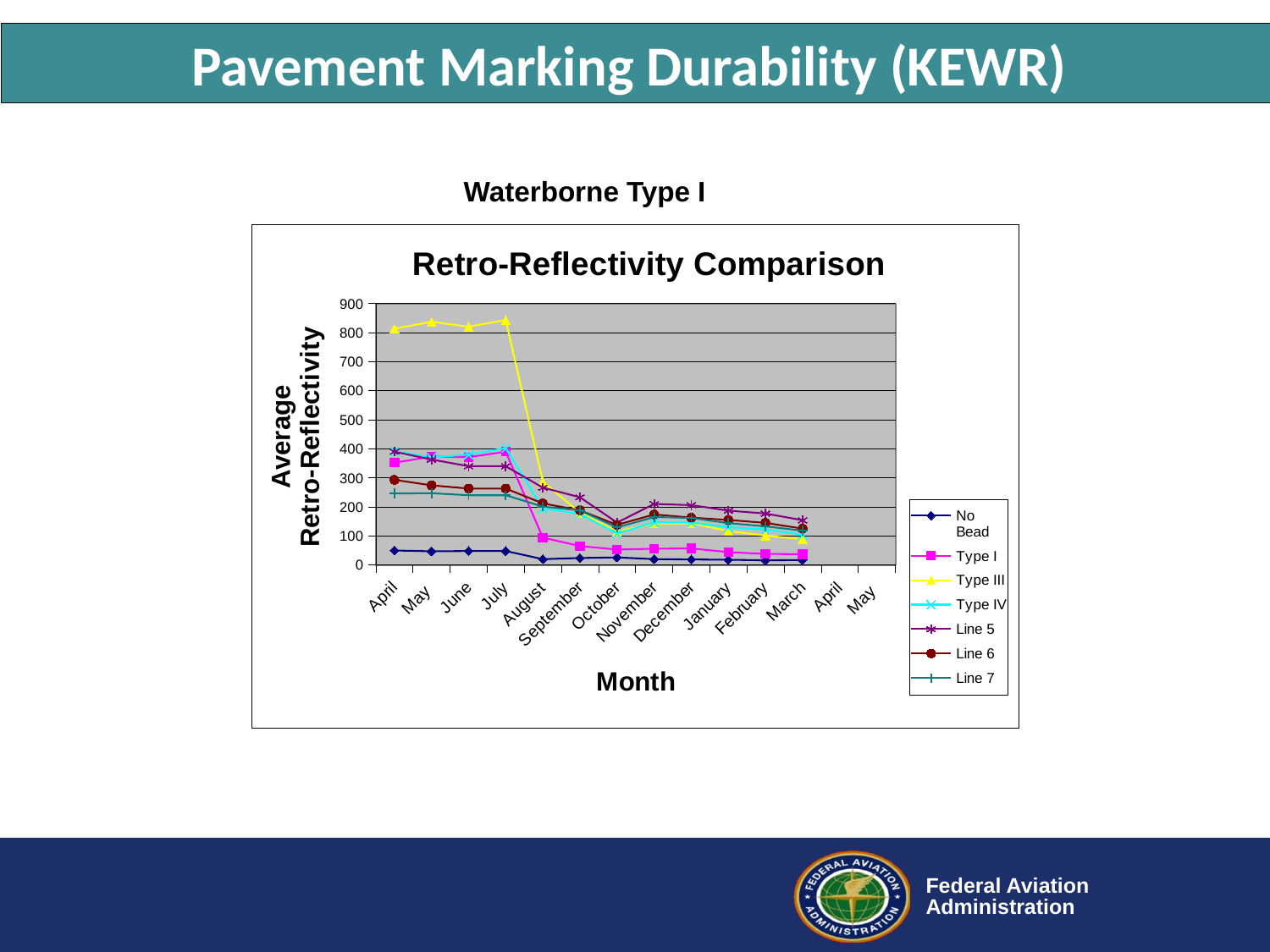
Does the Type III series rise or fall overall from April to March? fall Which series has the lowest value in April? No Bead How many series does the legend of the Retro-Reflectivity Comparison chart list? 7 Which series has the highest value in April? Type III In July, which is larger: the value for Type III or the value for No Bead? Type III Is the value for No Bead in April greater or less than 100? less Is the value for Line 7 in April greater or less than 300? less How many month labels appear along the x axis of the chart? 14 What is the title of the chart's y axis? Average Retro-Reflectivity What kind of chart is shown on the slide? line chart Is the value for Type III in July greater or less than 800? greater